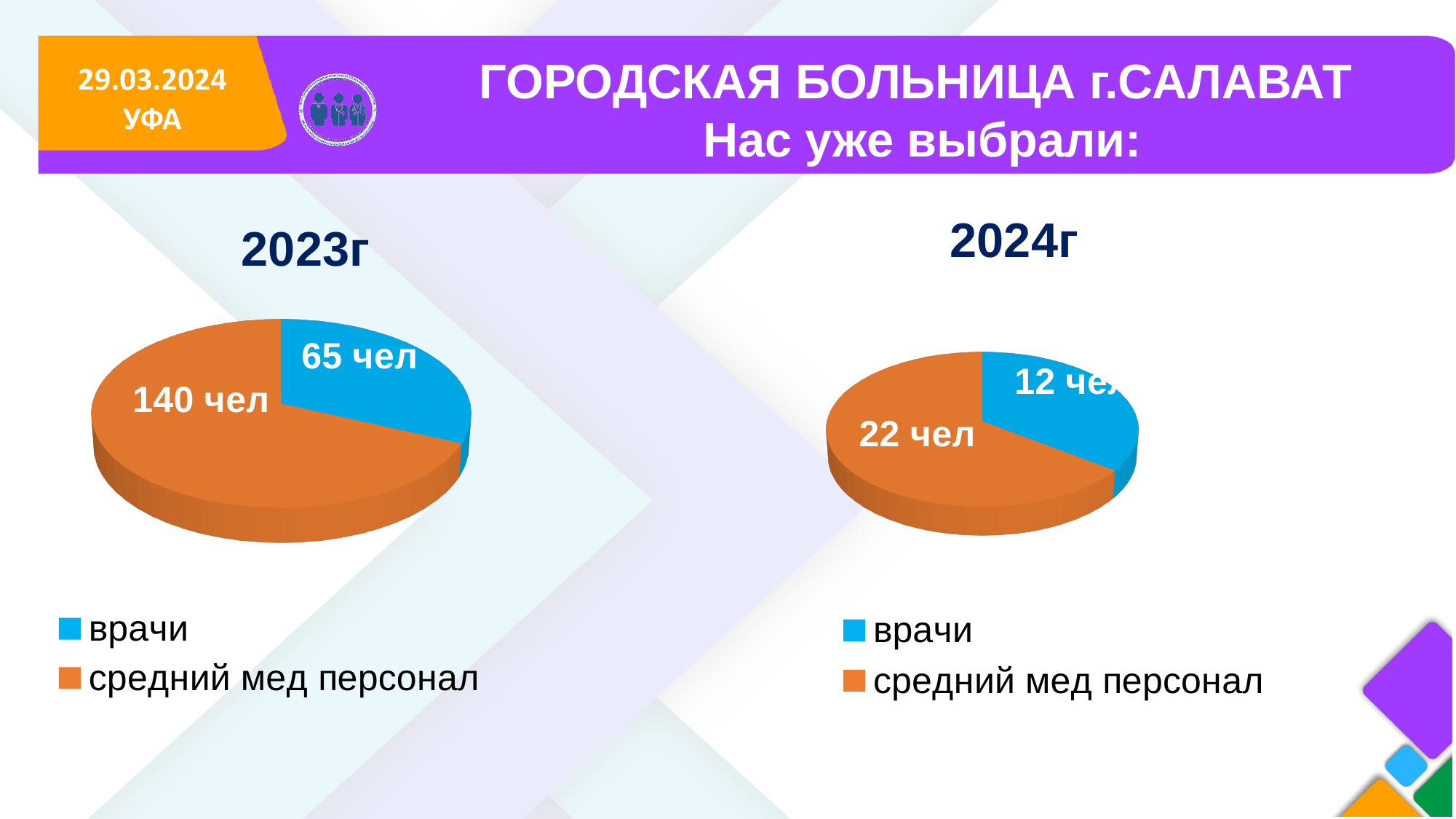
In the 2023г chart, what is the value for средний мед персонал? 140 чел In the 2023г chart, how many people are in the врачи slice? 65 чел In the 2024г chart, what is the value for врачи? 12 чел Is the врачи value larger in the 2023г chart or the 2024г chart? 2023г In the 2023г chart, which category has the largest slice? средний мед персонал In the 2024г chart, which category has the smallest slice? врачи How many categories does the legend of the 2024г chart list? 2 In the 2023г chart, what is the difference between средний мед персонал and врачи? 75 чел In the 2024г chart, how many people are in the средний мед персонал slice? 22 чел In the 2024г chart, what colour is the врачи slice? blue In the 2024г chart, by how much does средний мед персонал exceed врачи? 10 чел What type of chart is used for the 2023г data? pie chart